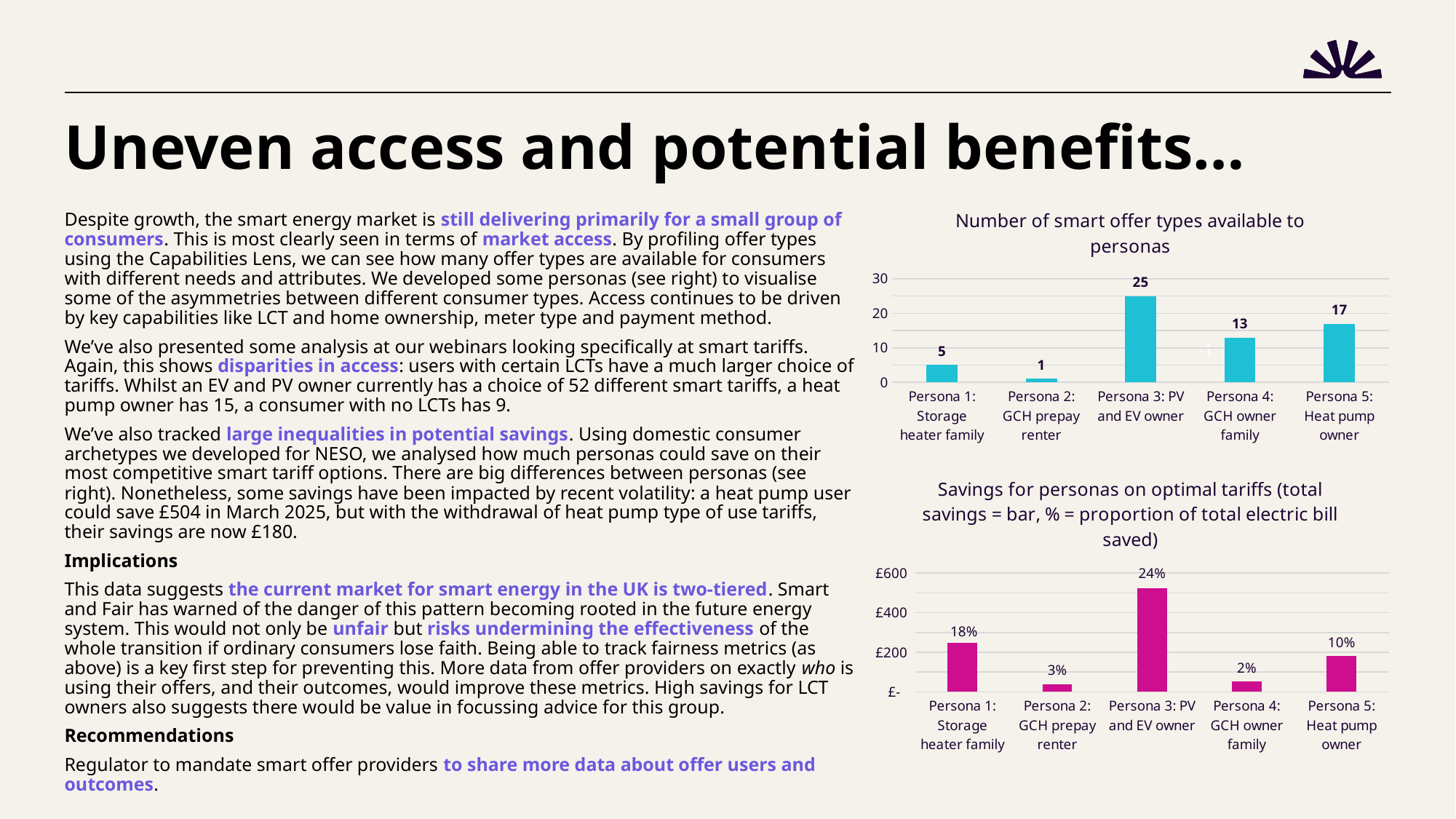
In the chart 'Number of smart offer types available to personas', which persona has the fewest smart offer types available? Persona 2: GCH prepay renter In the chart 'Savings for personas on optimal tariffs', which persona has the larger savings bar: Persona 1: Storage heater family or Persona 2: GCH prepay renter? Persona 1: Storage heater family In the chart 'Number of smart offer types available to personas', what is the difference between the number of offer types for Persona 5: Heat pump owner and Persona 4: GCH owner family? 4 What type of chart is 'Number of smart offer types available to personas'? Bar chart In the chart 'Number of smart offer types available to personas', how many smart offer types are available to Persona 2: GCH prepay renter? 1 In the chart 'Number of smart offer types available to personas', how many smart offer types are available to Persona 3: PV and EV owner? 25 In the chart 'Savings for personas on optimal tariffs', is the savings bar for Persona 3: PV and EV owner greater or less than £400? greater In the chart 'Number of smart offer types available to personas', how many personas are shown? 5 In the chart 'Savings for personas on optimal tariffs', what proportion of the total electric bill is saved by Persona 3: PV and EV owner? 24% In the chart 'Savings for personas on optimal tariffs', is the savings bar for Persona 5: Heat pump owner greater or less than £200? less In the chart 'Number of smart offer types available to personas', which persona has the most smart offer types available? Persona 3: PV and EV owner In the chart 'Savings for personas on optimal tariffs', what proportion of the total electric bill is saved by Persona 4: GCH owner family? 2%